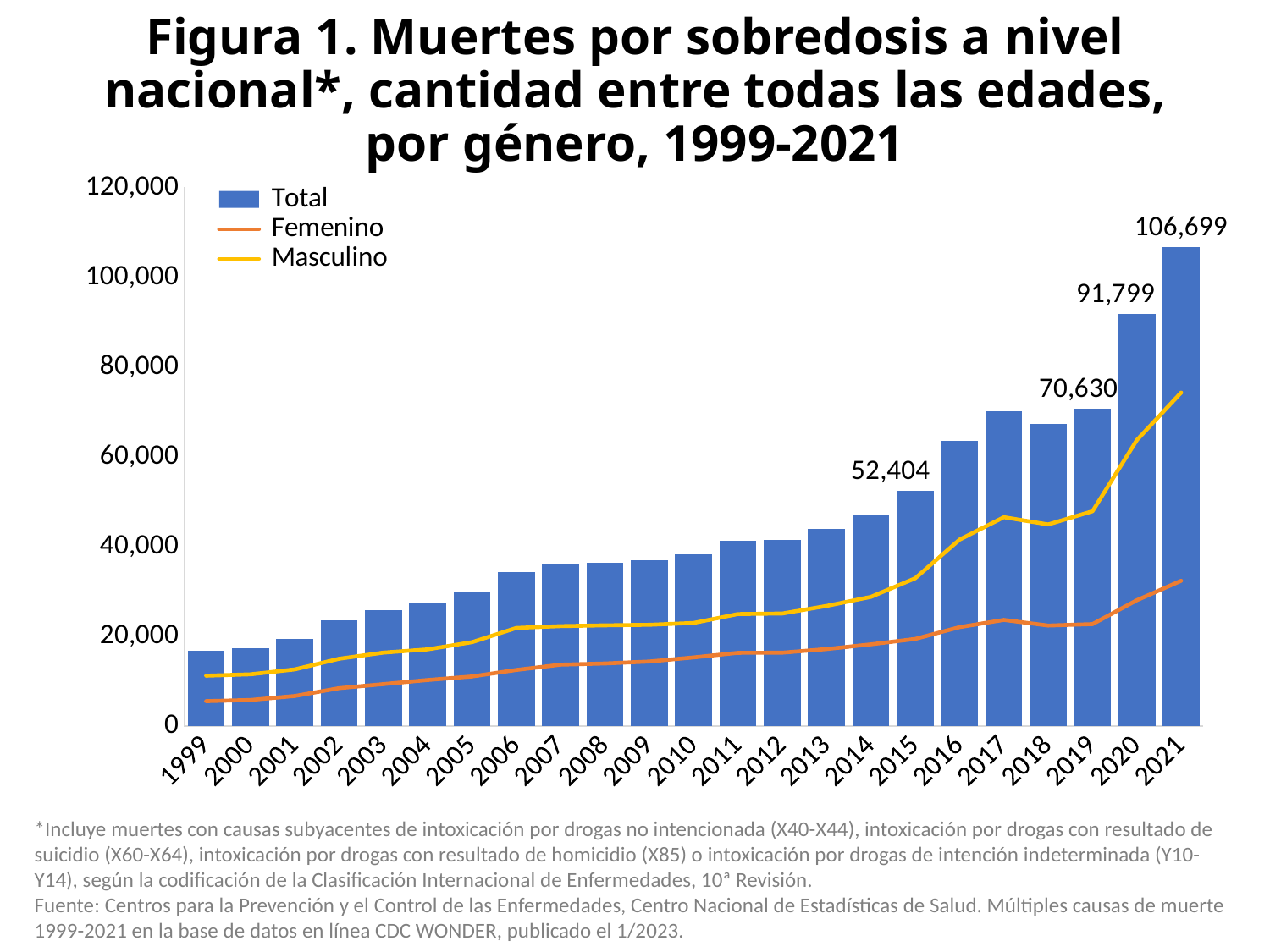
How many series does the legend list? 3 Is the Total value for 2010 greater or less than 40,000? less Which year has the highest Total? 2021 What is the Total value for 2020? 91,799 What is the Total value for 2021? 106,699 Is the Masculino value for 2021 greater or less than 60,000? greater What is the difference between the Total for 2021 and the Total for 2020? 14,900 What is the Total value for 2015? 52,404 In 2021, which is larger, the Masculino value or the Femenino value? Masculino How many years are shown on the x axis? 23